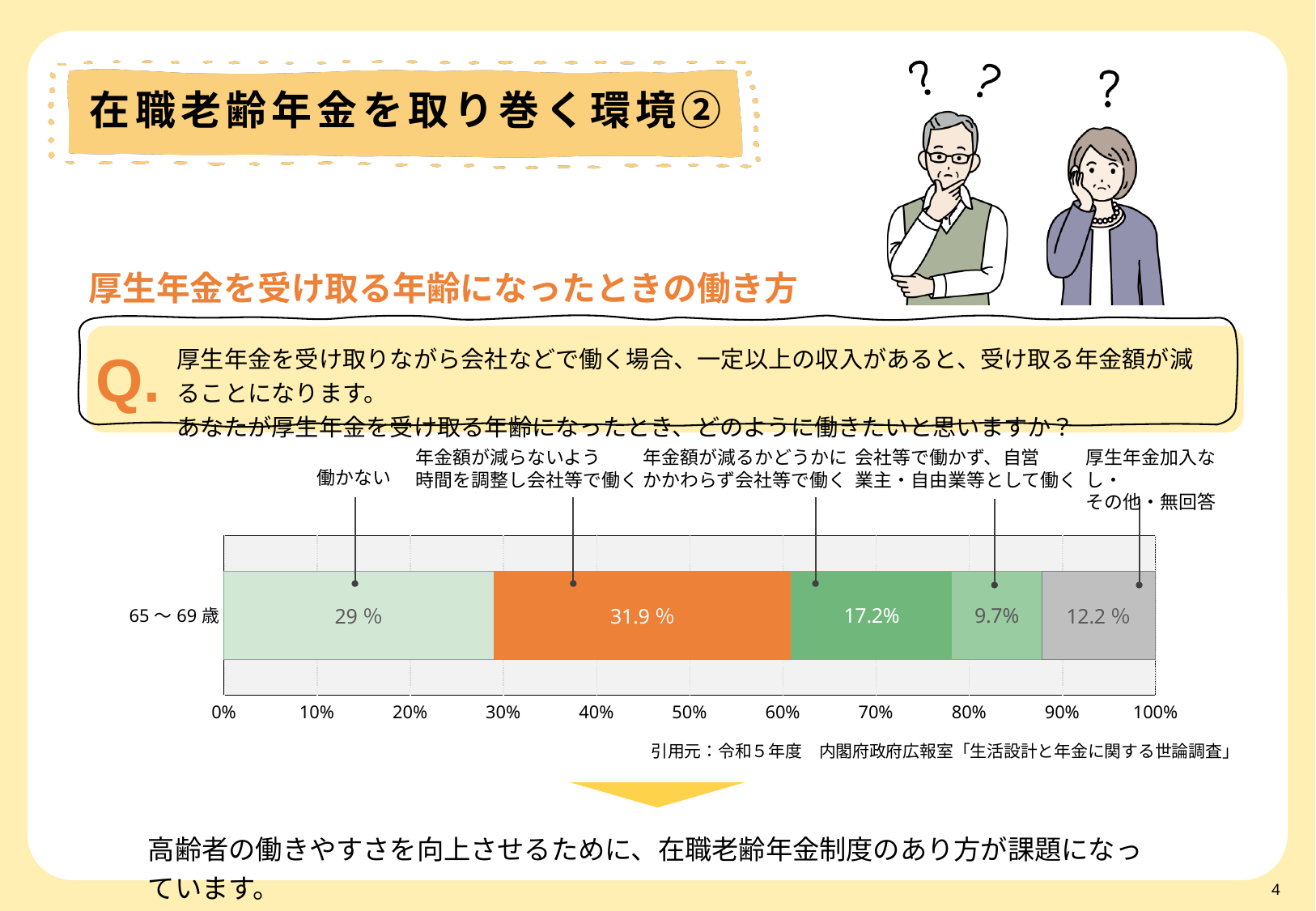
「年金額が減るかどうかにかかわらず会社等で働く」と「厚生年金加入なし・その他・無回答」では、どちらの割合が大きいですか？ 年金額が減るかどうかにかかわらず会社等で働く 「年金額が減らないよう時間を調整し会社等で働く」の割合はいくつですか？ 31.9 % 最も割合が高い回答はどれですか？ 年金額が減らないよう時間を調整し会社等で働く この棒グラフには回答区分がいくつありますか？ 5 これはどの種類のグラフですか？ 積み上げ棒グラフ 「働かない」の割合はいくつですか？ 29 % 「会社等で働かず、自営業主・自由業等として働く」の割合はいくつですか？ 9.7% 「厚生年金加入なし・その他・無回答」の割合はいくつですか？ 12.2 % 「年金額が減らないよう時間を調整し会社等で働く」と「働かない」の割合の差は何ポイントですか？ 2.9ポイント 「年金額が減るかどうかにかかわらず会社等で働く」の割合はいくつですか？ 17.2% グラフに示されている年齢区分は何ですか？ 65～69歳 最も割合が低い回答はどれですか？ 会社等で働かず、自営業主・自由業等として働く